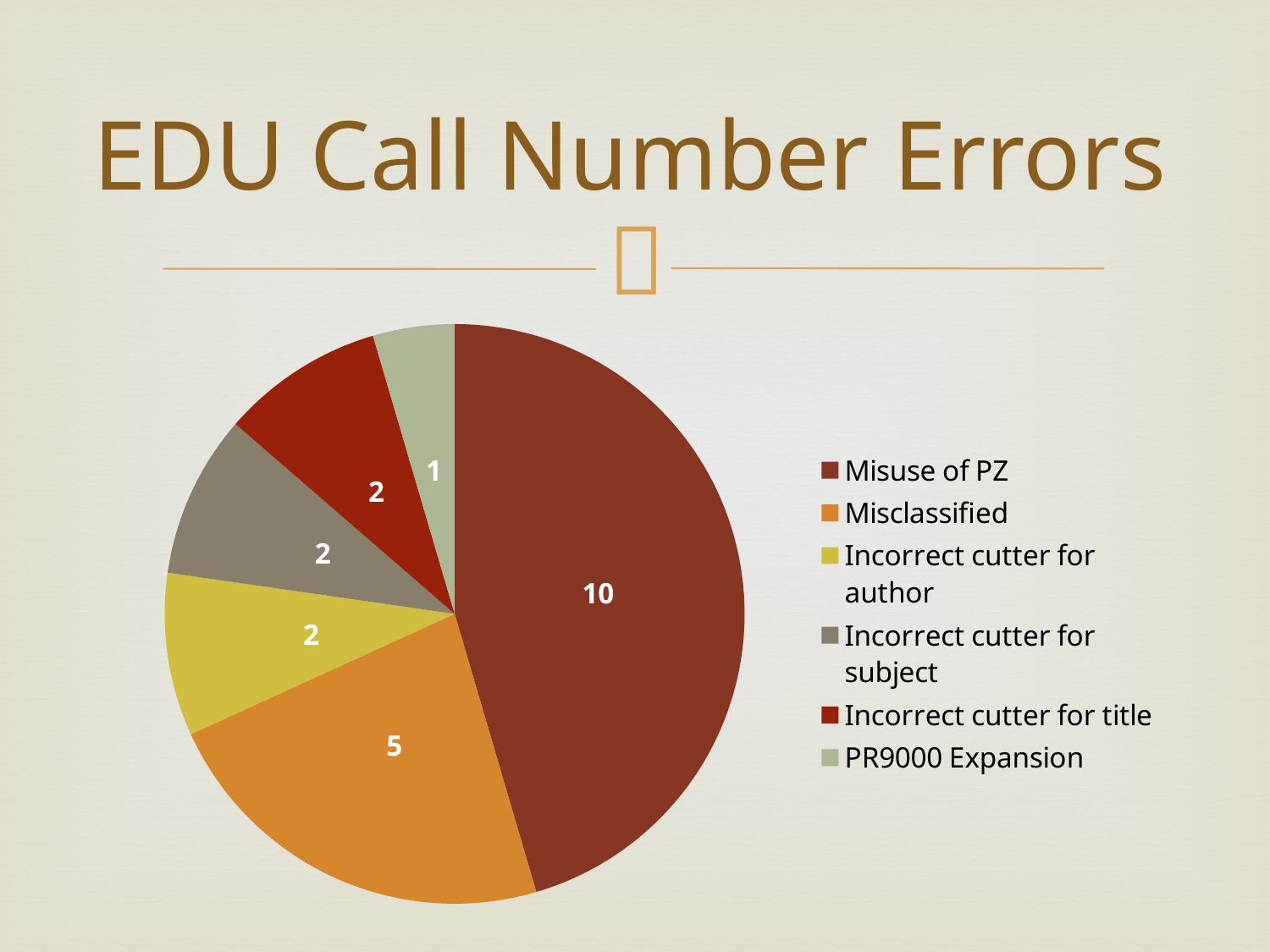
Which category has the smallest slice of the pie? PR9000 Expansion What value is shown for the Misclassified slice? 5 What value is shown for the Incorrect cutter for title slice? 2 What is the title of the slide containing the chart? EDU Call Number Errors What is the difference between the Misuse of PZ value and the Misclassified value? 5 What value is shown for the Misuse of PZ slice? 10 Which is larger, the Misclassified slice or the Incorrect cutter for author slice? Misclassified What value is shown for the PR9000 Expansion slice? 1 How many slices does the pie chart have? 6 Which category has the largest slice of the pie? Misuse of PZ What kind of chart is shown on the slide? Pie chart What is the difference between the Misclassified value and the PR9000 Expansion value? 4